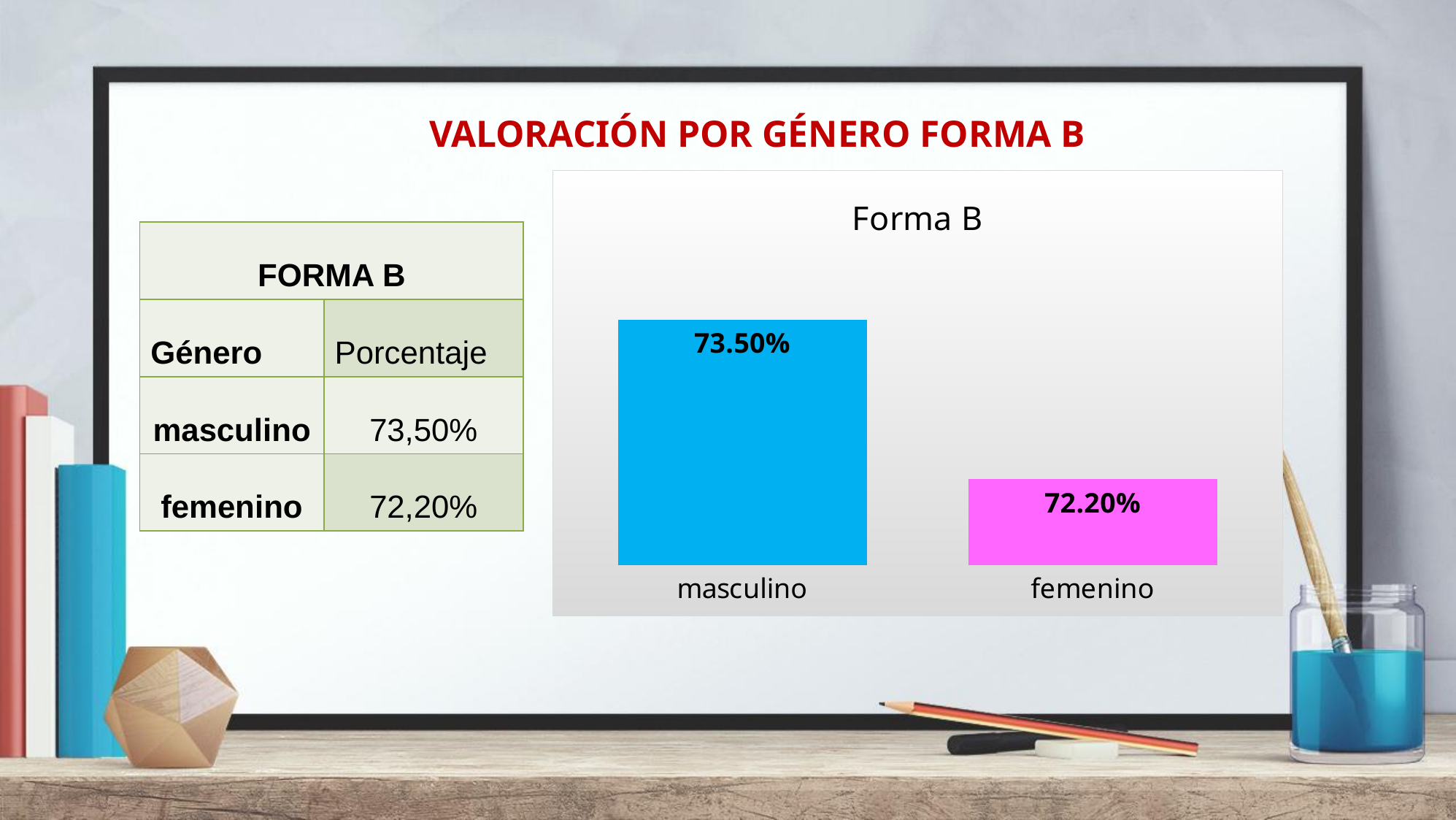
What is the title of the chart on the slide? Forma B What is the value for masculino in the Forma B chart? 73.50% What colour is the femenino bar in the Forma B chart? magenta Which is larger in the Forma B chart, masculino or femenino? masculino Which category has the lowest value in the Forma B chart? femenino Which category has the highest value in the Forma B chart? masculino What kind of chart is the Forma B chart? bar chart How many categories are shown in the Forma B chart? 2 What is the value for femenino in the Forma B chart? 72.20% What is the difference between the masculino and femenino values in the Forma B chart? 1.30%